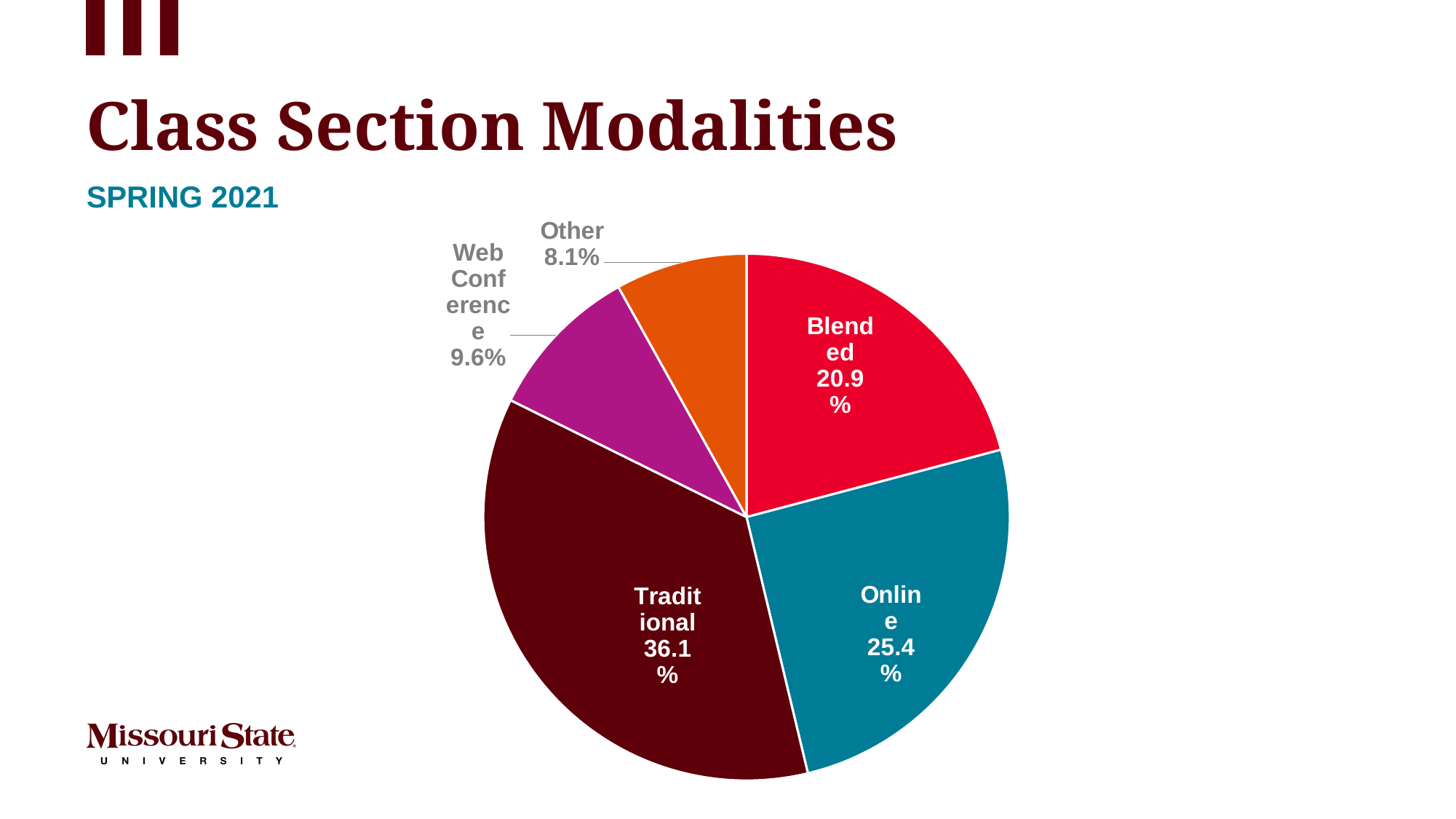
What share of class sections is Online? 25.4% How many modalities are shown in the pie chart? 5 How many percentage points larger is the Traditional share than the Online share? 10.7 What share of class sections is Other? 8.1% Which modality has the smallest share of class sections? Other Which modality has the largest share of class sections? Traditional What share of class sections is Blended? 20.9% Which has a larger share, Blended or Web Conference? Blended What share of class sections is Traditional? 36.1% What kind of chart is shown on the slide? Pie chart What semester does the chart cover? Spring 2021 What share of class sections is Web Conference? 9.6%